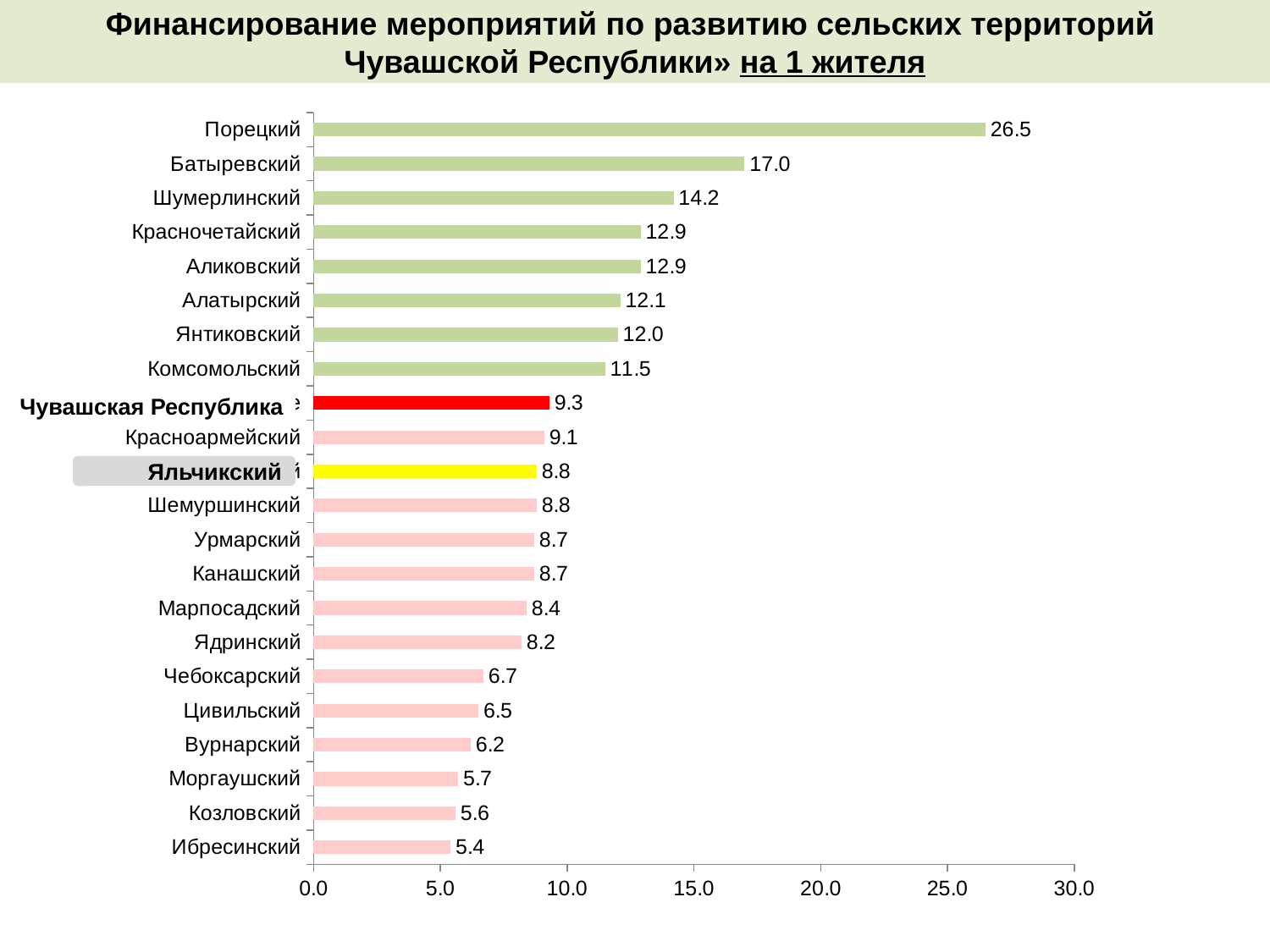
Which category has the lowest value? Ибресинский What is the difference between the values for Чувашская Республика and Яльчикский? 0.5 What is the value for Чувашская Республика? 9.3 What is the value for Порецкий? 26.5 How many categories are shown in the chart? 22 What is the value for Яльчикский? 8.8 Which is larger, the value for Шумерлинский or the value for Комсомольский? Шумерлинский What is the difference between the values for Порецкий and Батыревский? 9.5 Which category has the highest value? Порецкий What kind of chart is shown on the slide? bar chart What colour is the bar for Чувашская Республика? red Is the value for Батыревский greater or less than 15.0? greater